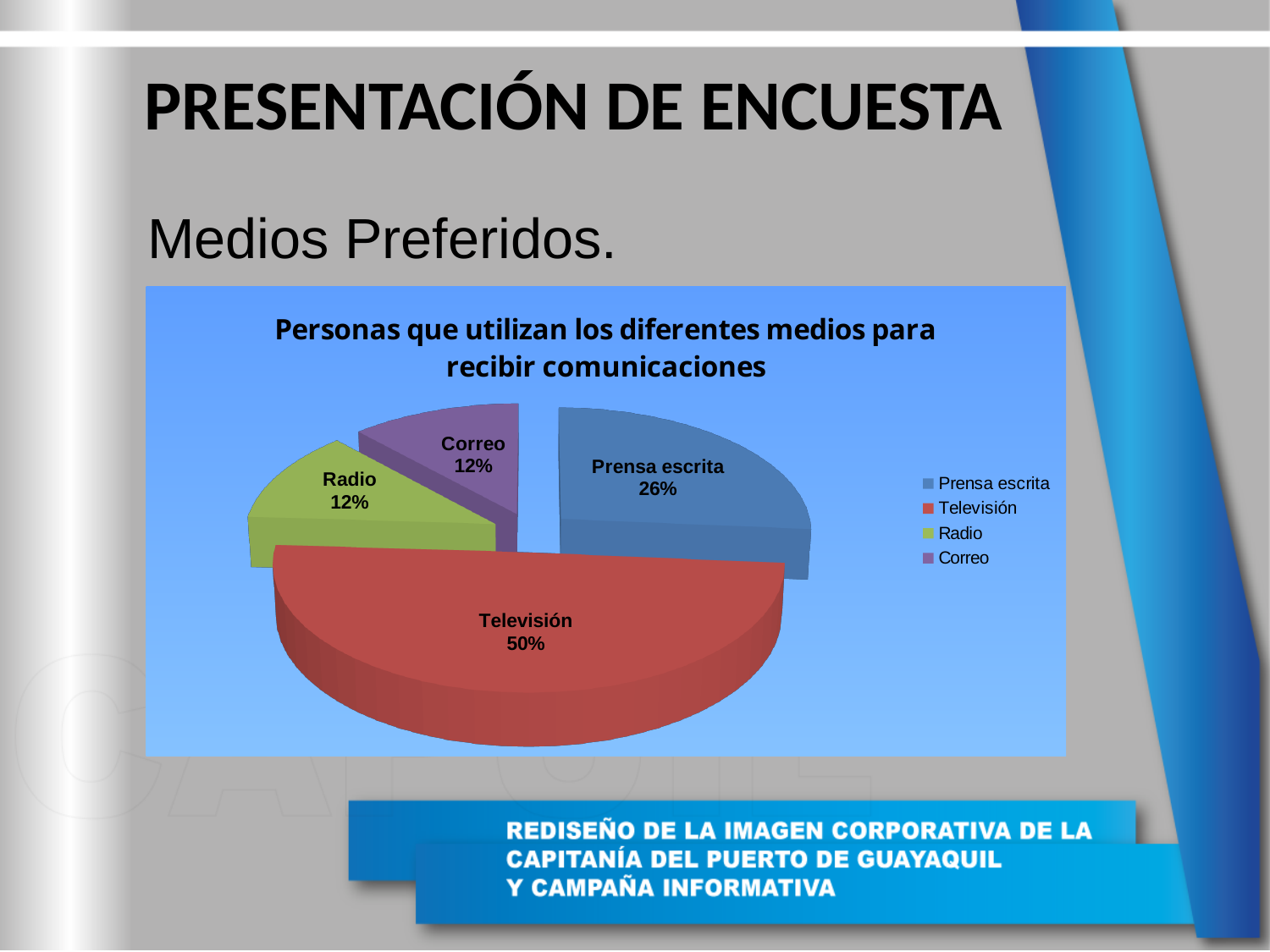
What percentage is shown for Correo? 12% What percentage is shown for Radio? 12% What percentage is shown for Prensa escrita? 26% What colour is the Televisión slice? Red What percentage of people use Televisión to receive communications? 50% What type of chart is shown on the slide? Pie chart What is the difference in percentage points between Televisión and Prensa escrita? 24 Which is larger, the share for Prensa escrita or the share for Radio? Prensa escrita How many entries does the legend list? 4 Which medium has the largest share of the pie? Televisión How many slices does the pie chart have? 4 What is the title of the chart? Personas que utilizan los diferentes medios para recibir comunicaciones